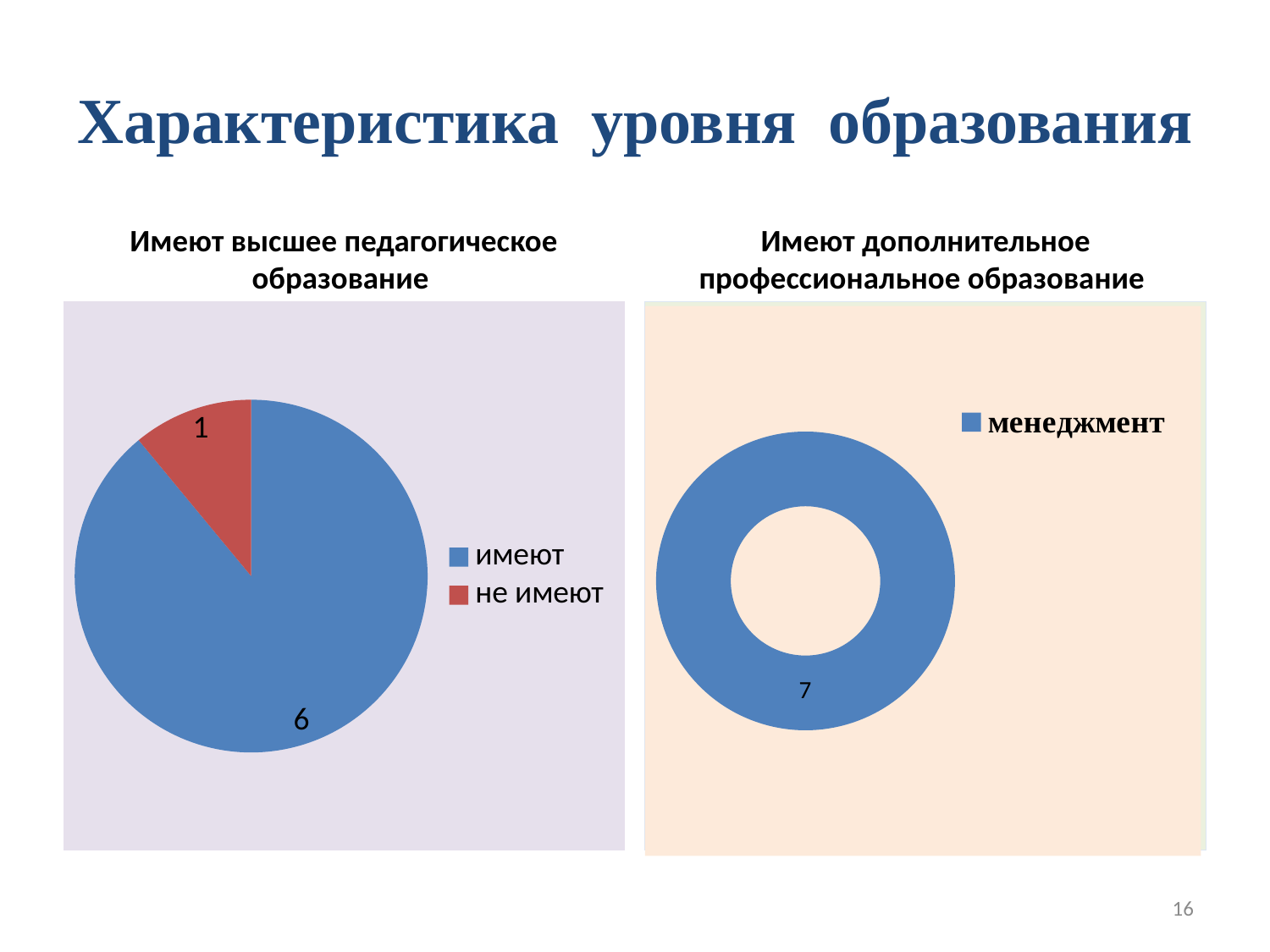
In the chart titled "Имеют высшее педагогическое образование", which category has the smallest slice? не имеют In the chart titled "Имеют высшее педагогическое образование", which is larger: "имеют" or "не имеют"? имеют What type of chart is the one titled "Имеют высшее педагогическое образование"? pie chart In the chart titled "Имеют дополнительное профессиональное образование", what is the value for "менеджмент"? 7 In the chart titled "Имеют высшее педагогическое образование", what is the total of all slices? 7 In the chart titled "Имеют высшее педагогическое образование", what is the value for "не имеют"? 1 In the chart titled "Имеют высшее педагогическое образование", what is the difference between the values for "имеют" and "не имеют"? 5 In the chart titled "Имеют высшее педагогическое образование", what colour is the "не имеют" slice? red In the chart titled "Имеют высшее педагогическое образование", what is the value for "имеют"? 6 In the chart titled "Имеют высшее педагогическое образование", how many slices does the pie have? 2 In the chart titled "Имеют высшее педагогическое образование", which category has the largest slice? имеют How many entries does the legend of the chart titled "Имеют дополнительное профессиональное образование" list? 1